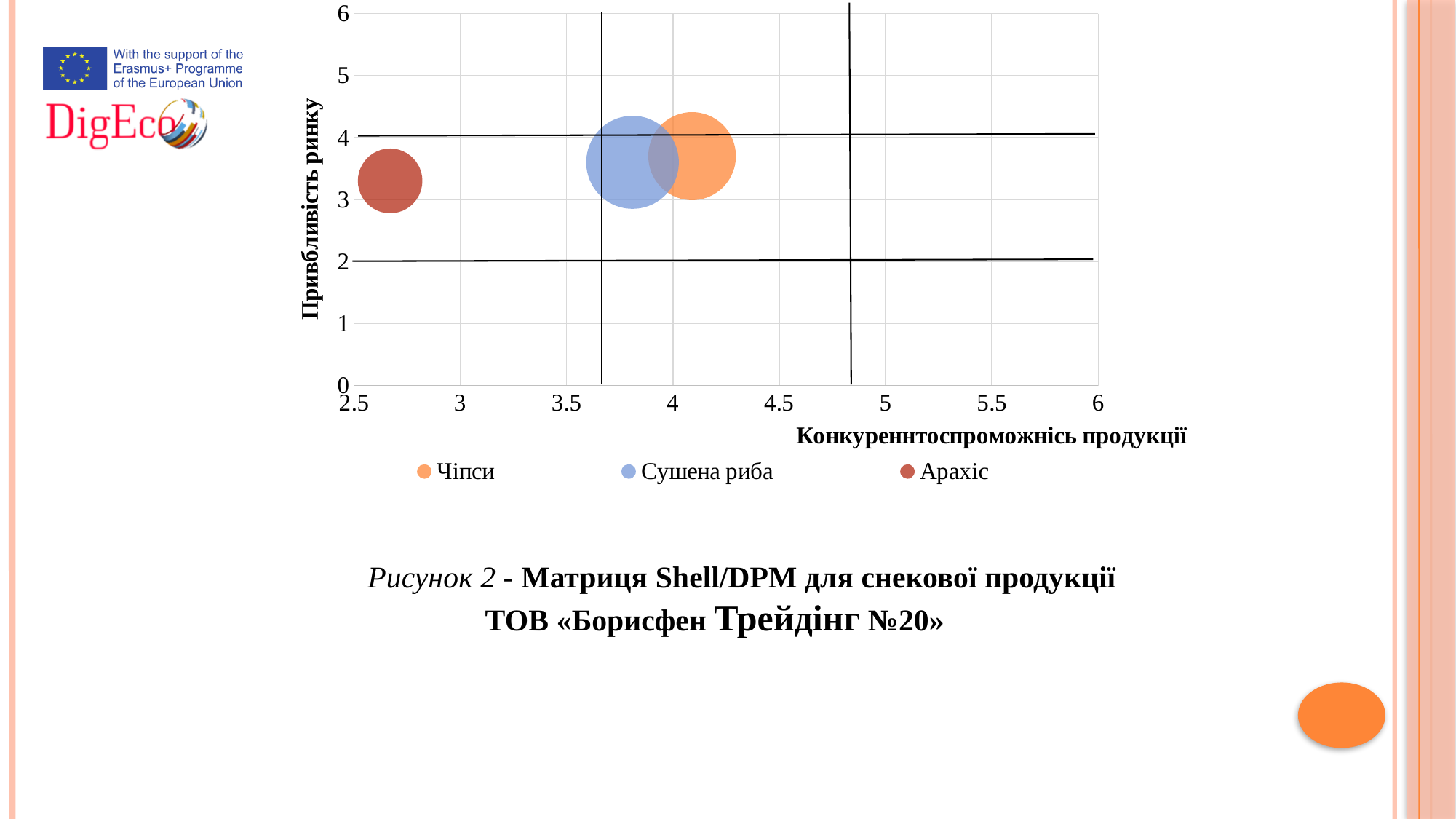
Which series has a larger horizontal-axis value, Чіпси or Арахіс? Чіпси Which series has the lowest value on the vertical axis (Привбливість ринку)? Арахіс Is the vertical-axis value for Арахіс greater or less than 3? greater What is the title of the vertical axis? Привбливість ринку What kind of chart is shown on the slide? bubble chart Is the horizontal-axis value for Сушена риба greater or less than 4? less How many series does the legend list? 3 Which series is plotted furthest to the right on the horizontal axis (Конкуреннтоспроможнісь продукції)? Чіпси Is the horizontal-axis value for Арахіс greater or less than 3? less Which series is plotted furthest to the left on the horizontal axis (Конкуреннтоспроможнісь продукції)? Арахіс How many bubbles are plotted on the chart? 3